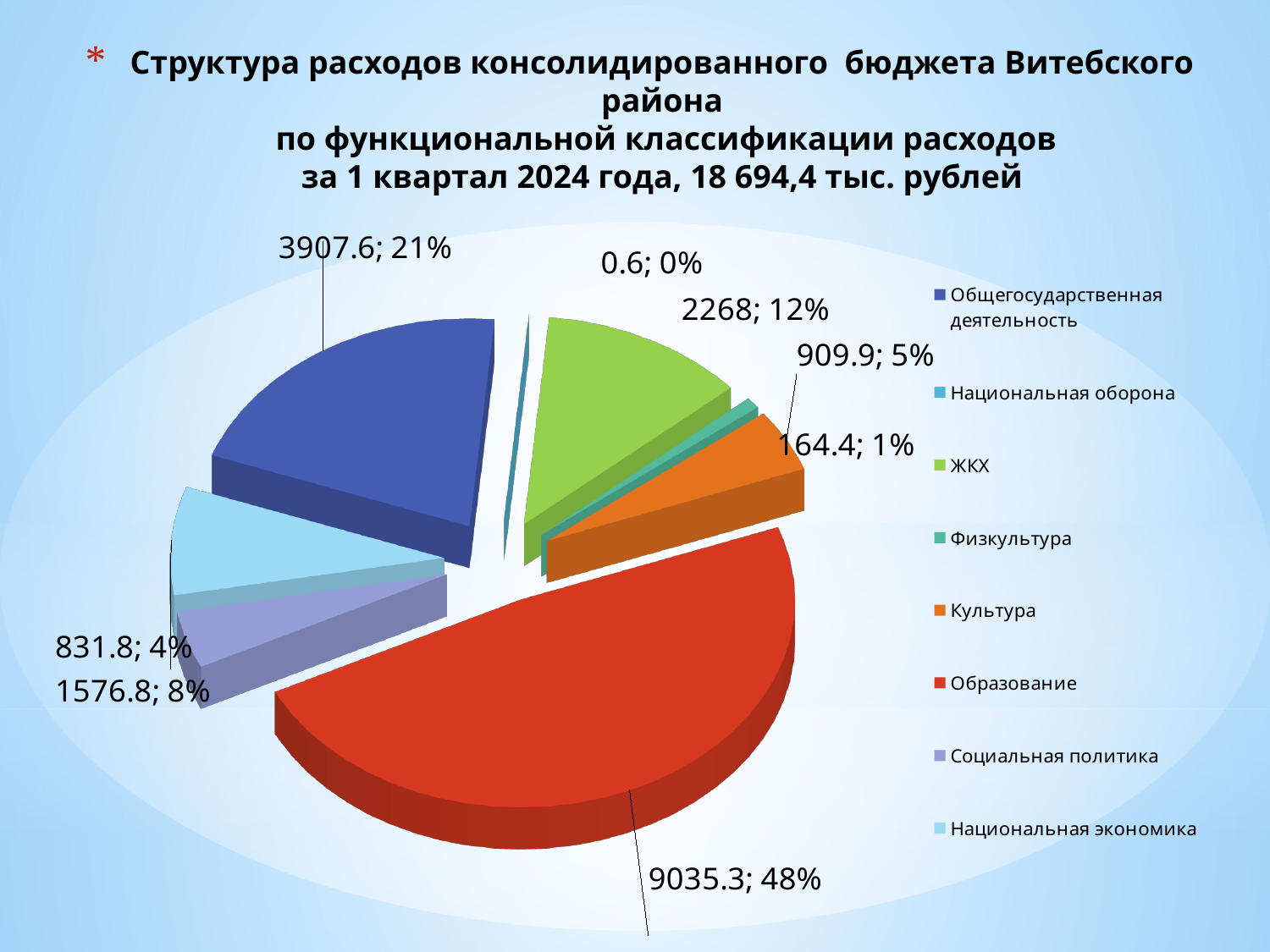
Which is larger, the value for Культура or the value for Физкультура? Культура What share of the pie does Образование represent? 48% How many categories does the legend of the pie chart list? 8 What value is shown for Общегосударственная деятельность? 3907.6 Which category has the smallest slice of the pie? Национальная оборона What kind of chart is shown on the slide? pie chart What colour is the slice for Образование? red What value is shown for Образование? 9035.3 Which category has the largest slice of the pie? Образование What value is shown for Национальная оборона? 0.6 What share of the pie does ЖКХ represent? 12% What is the difference between the values for Образование and Общегосударственная деятельность? 5127.7